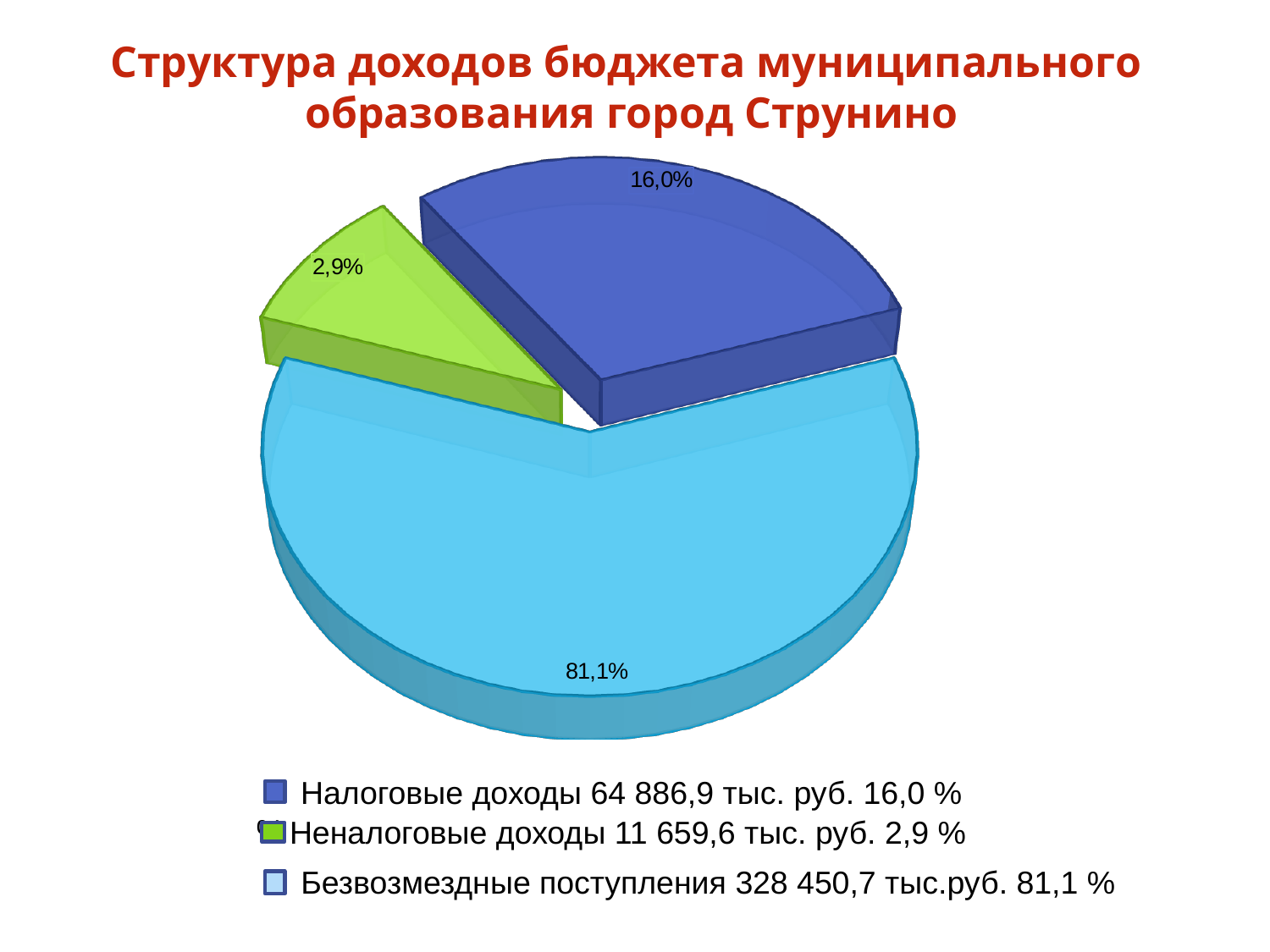
According to the legend, what is the amount in тыс. руб. for Налоговые доходы? 64 886,9 тыс. руб. How many slices does the pie chart have? 3 What share of the pie does Налоговые доходы have? 16,0% What share of the pie does Безвозмездные поступления have? 81,1% What is the difference in percentage points between the share for Безвозмездные поступления and the share for Налоговые доходы? 65,1 What kind of chart is shown on the slide? Pie chart Which is larger: the share for Налоговые доходы or the share for Неналоговые доходы? Налоговые доходы Which category has the largest share of the pie? Безвозмездные поступления What colour is the slice for Неналоговые доходы? Green Which category has the smallest share of the pie? Неналоговые доходы According to the legend, what is the amount in тыс. руб. for Безвозмездные поступления? 328 450,7 тыс.руб. What share of the pie does Неналоговые доходы have? 2,9%